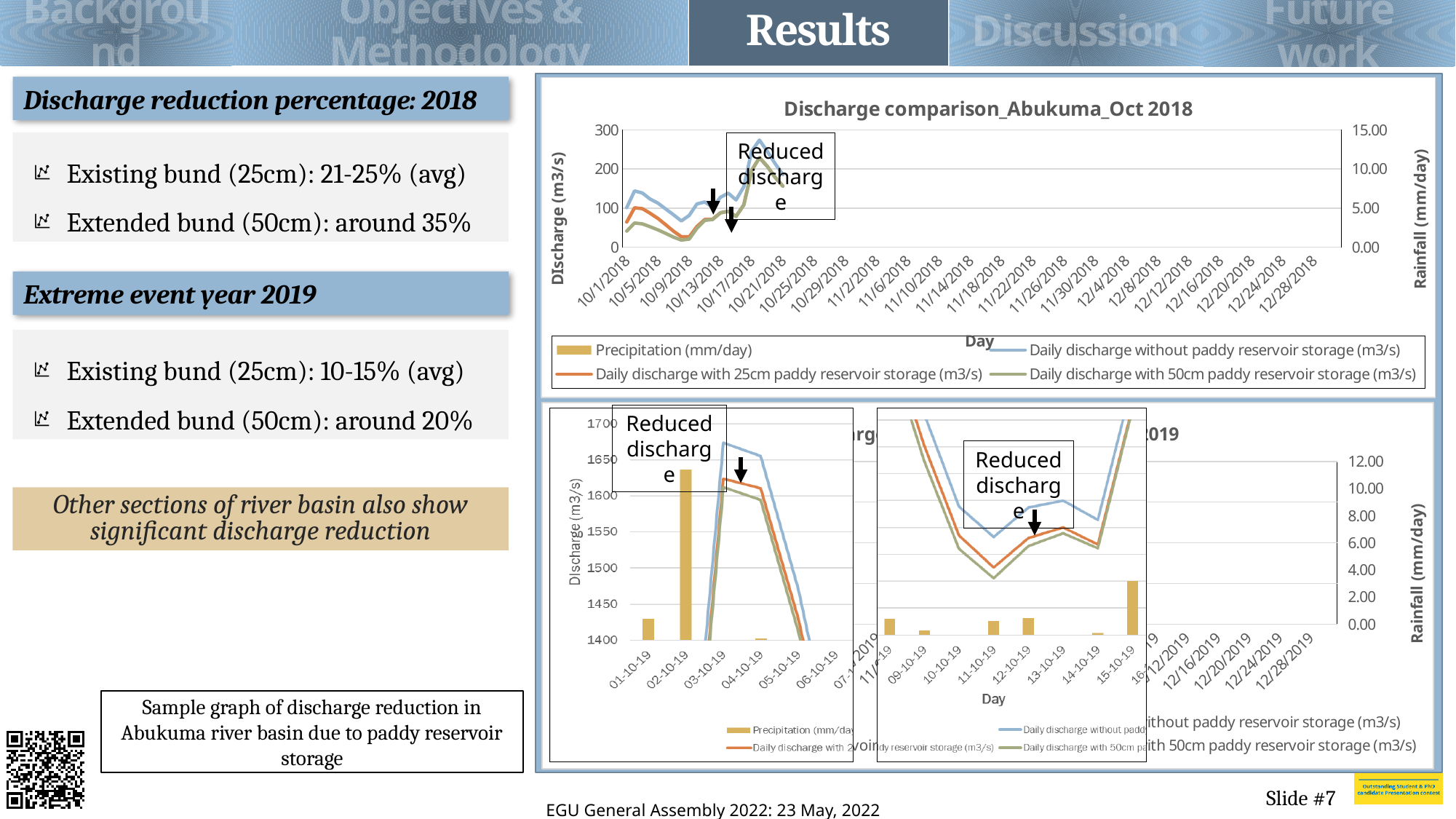
In the top chart (Discharge comparison_Abukuma_Oct 2018), is the peak value of daily discharge without paddy reservoir storage greater or less than 200? greater What is the title of the top chart? Discharge comparison_Abukuma_Oct 2018 In the left inset chart of the bottom panel, does the daily discharge without paddy reservoir storage rise or fall from 04-10-19 to 06-10-19? fall In the top chart (Discharge comparison_Abukuma_Oct 2018), what kind of chart is used for the daily discharge series? Line chart In the left inset chart of the bottom panel (x axis 01-10-19 to 06-10-19), on which day is the precipitation bar tallest? 02-10-19 In the top chart (Discharge comparison_Abukuma_Oct 2018), is the daily discharge with 50cm paddy reservoir storage on 10/9/2018 greater or less than 100? less In the top chart (Discharge comparison_Abukuma_Oct 2018), which is larger at the peak near 10/17/2018: daily discharge without paddy reservoir storage or daily discharge with 25cm paddy reservoir storage? Daily discharge without paddy reservoir storage (m3/s) In the right inset chart of the bottom panel (x axis 09-10-19 to 15-10-19), on which day is the precipitation bar tallest? 15-10-19 In the top chart (Discharge comparison_Abukuma_Oct 2018), what is the label of the left vertical axis? DIscharge (m3/s) In the top chart (Discharge comparison_Abukuma_Oct 2018), is the daily discharge without paddy reservoir storage on 10/5/2018 greater or less than 100? greater In the top chart (Discharge comparison_Abukuma_Oct 2018), how many series does the legend list? 4